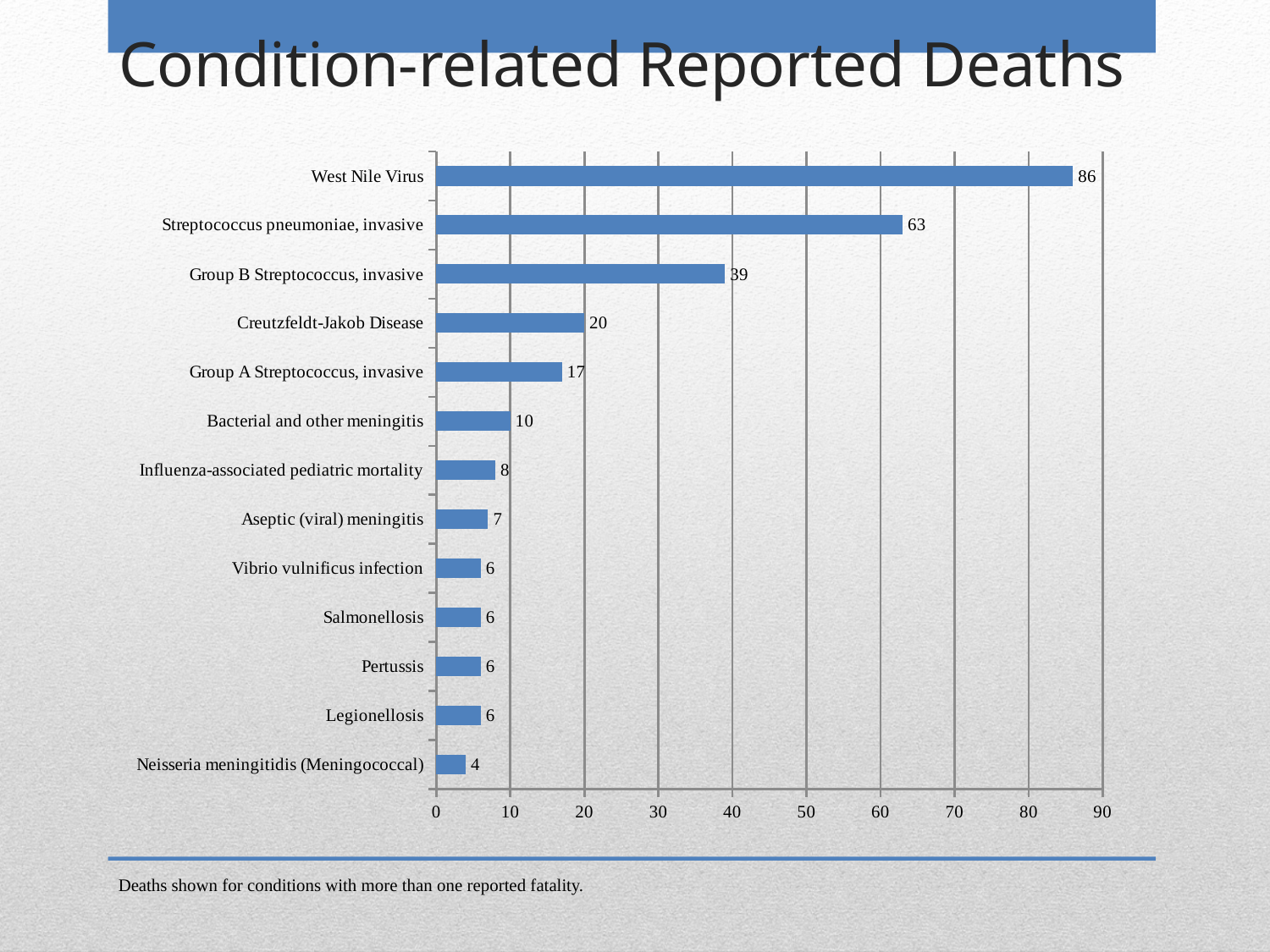
Is the value for Group B Streptococcus, invasive greater or less than 40? less What kind of chart is shown on the slide? Bar chart What is the difference in reported deaths between West Nile Virus and Streptococcus pneumoniae, invasive? 23 Which condition has the highest number of reported deaths? West Nile Virus What is the difference between Group B Streptococcus, invasive and Group A Streptococcus, invasive? 22 How many conditions are listed on the chart? 13 How many reported deaths are shown for West Nile Virus? 86 Which has more reported deaths, Bacterial and other meningitis or Aseptic (viral) meningitis? Bacterial and other meningitis What is the value for Creutzfeldt-Jakob Disease? 20 Which condition has the lowest number of reported deaths? Neisseria meningitidis (Meningococcal) How many deaths are shown for Influenza-associated pediatric mortality? 8 What is the title of the slide? Condition-related Reported Deaths